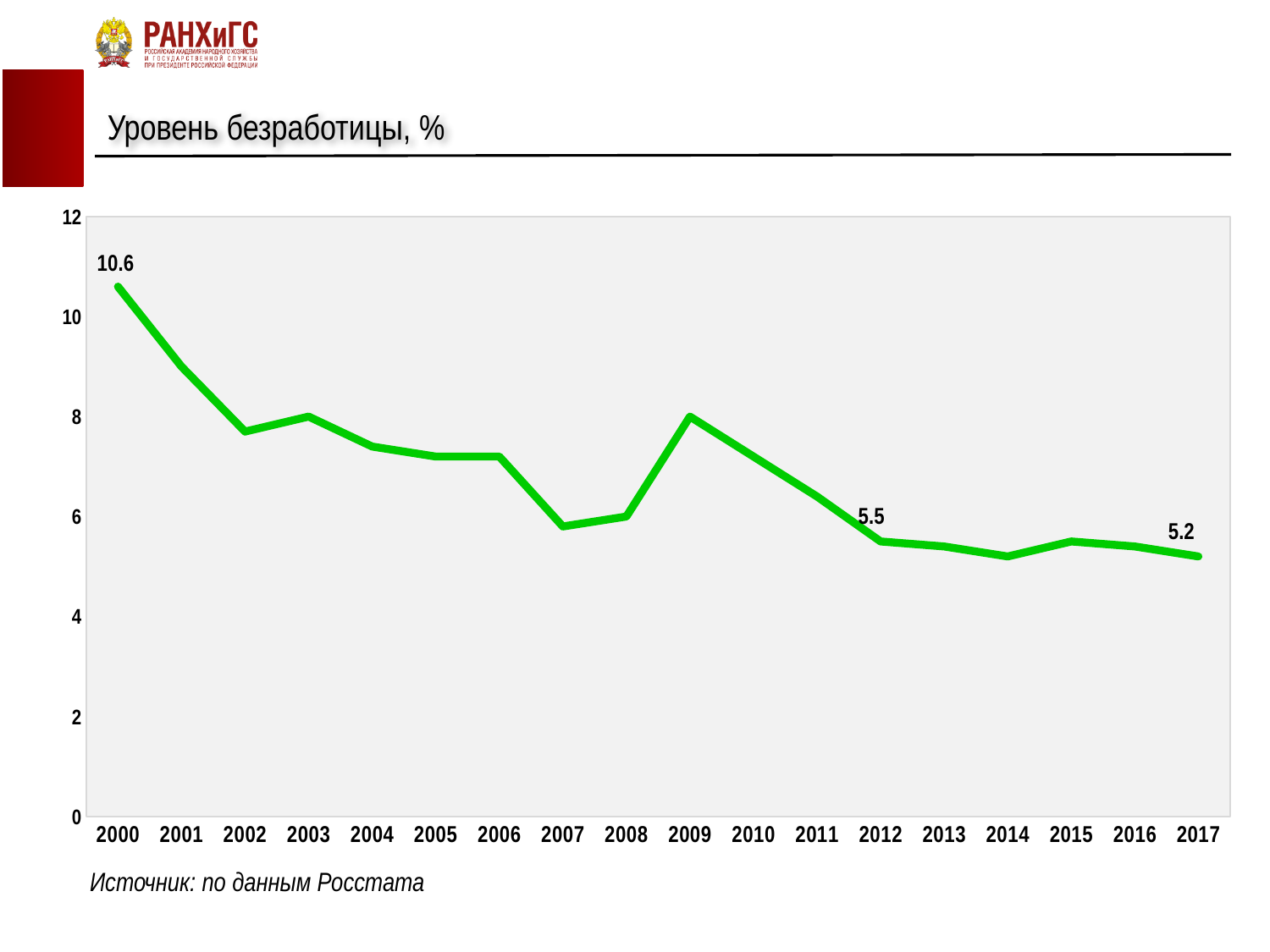
Is the value for 2007 greater or less than 8? less What value is labelled for 2012? 5.5 Is the value for 2009 greater or less than 6? greater What kind of chart is shown on the slide? line chart Is the value for 2001 greater or less than 8? greater What is the unemployment rate shown for 2000? 10.6 What is the difference between the labelled values for 2012 and 2017? 0.3 How many years are plotted on the x axis? 18 What value is labelled for 2017? 5.2 Which year has the highest unemployment rate on the chart? 2000 By how much did the labelled value fall from 2000 to 2017? 5.4 Which year has the larger value, 2000 or 2017? 2000